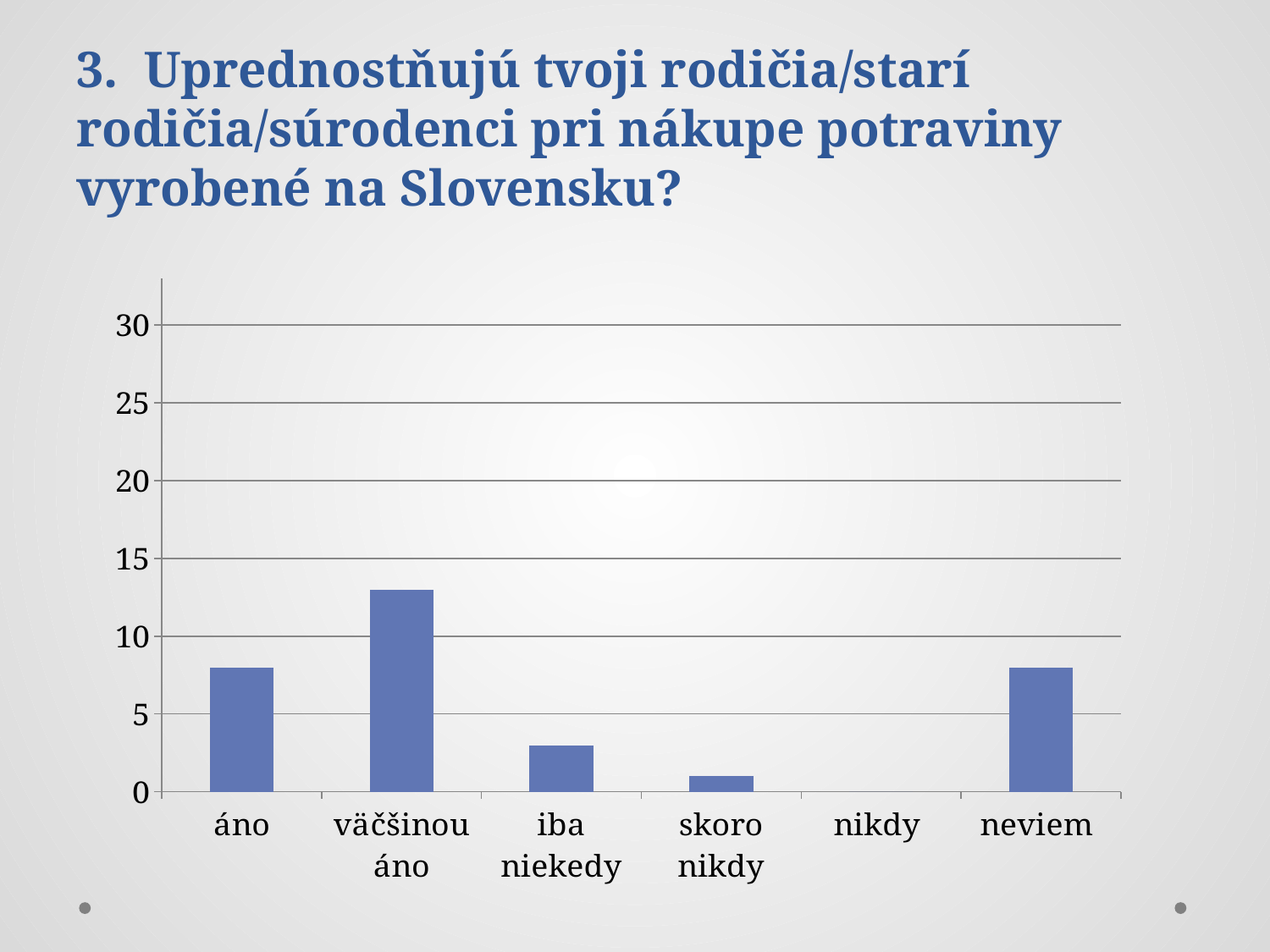
Which category has the highest bar in the chart? väčšinou áno What kind of chart is shown on the slide? bar chart What is the highest value shown on the vertical axis of the chart? 30 Is the value for 'áno' greater or less than 10? less Is the value for 'väčšinou áno' greater or less than 10? greater Which category has the lowest value in the chart? nikdy Is the value for 'neviem' greater or less than 5? greater How many categories are shown on the x axis of the chart? 6 Which is larger, the value for 'áno' or the value for 'väčšinou áno'? väčšinou áno Which is larger, the value for 'iba niekedy' or the value for 'neviem'? neviem